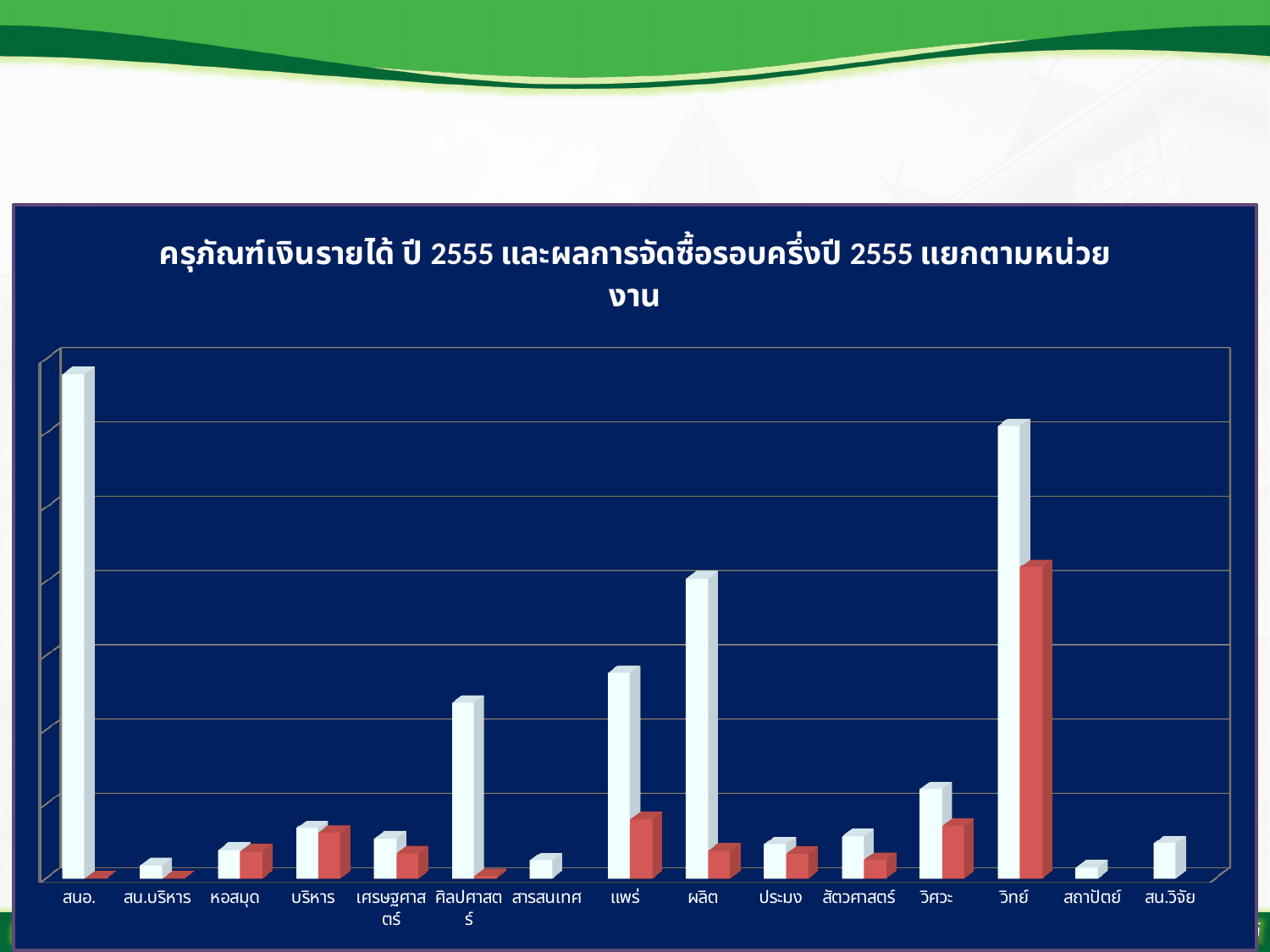
Which has the taller white bar, วิศวะ or ประมง? วิศวะ What is the title of the chart? ครุภัณฑ์เงินรายได้ ปี 2555 และผลการจัดซื้อรอบครึ่งปี 2555 แยกตามหน่วยงาน What two colours are used for the bars in the chart? White and red Which category has the tallest white bar in the chart? สนอ. Which has the taller red bar, วิทย์ or แพร่? วิทย์ Which has the taller white bar, ศิลปศาสตร์ or สารสนเทศ? ศิลปศาสตร์ How many categories (units) are shown along the x axis of the chart? 15 What kind of chart is shown on the slide? Bar chart Which category has the tallest red bar in the chart? วิทย์